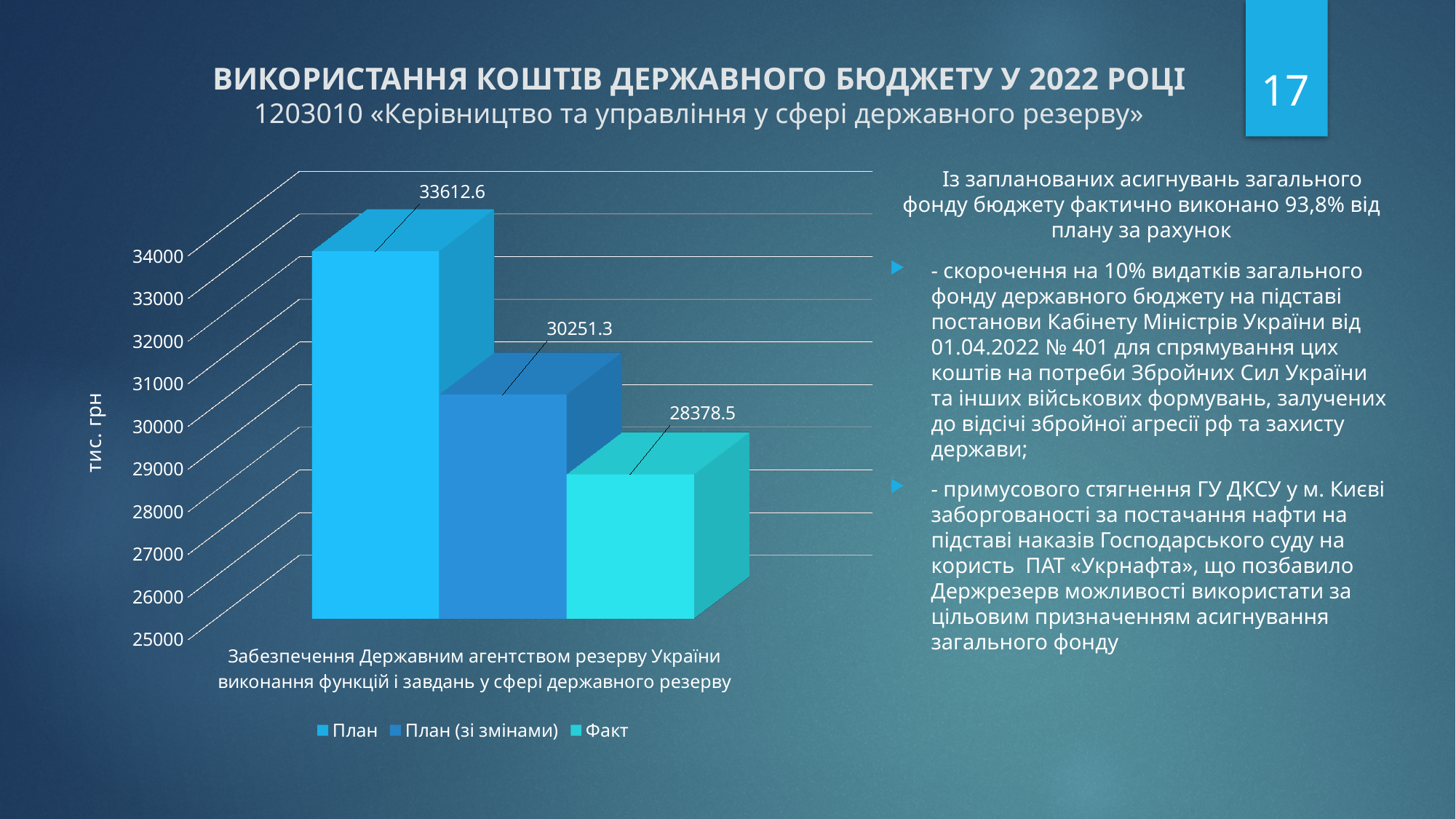
What is the value of the План series on the chart? 33612.6 What is the difference between the План value and the План (зі змінами) value? 3361.3 Which series has the lowest value on the chart? Факт How many series does the legend list? 3 What kind of chart is shown on the slide? bar chart What is the label on the vertical axis of the chart? тис. грн What is the difference between the План (зі змінами) value and the Факт value? 1872.8 What is the value of the Факт series on the chart? 28378.5 Is the value for Факт greater or less than 29000? less Which series has the highest value on the chart? План What is the value of the План (зі змінами) series on the chart? 30251.3 Which is larger, the План (зі змінами) value or the Факт value? План (зі змінами)